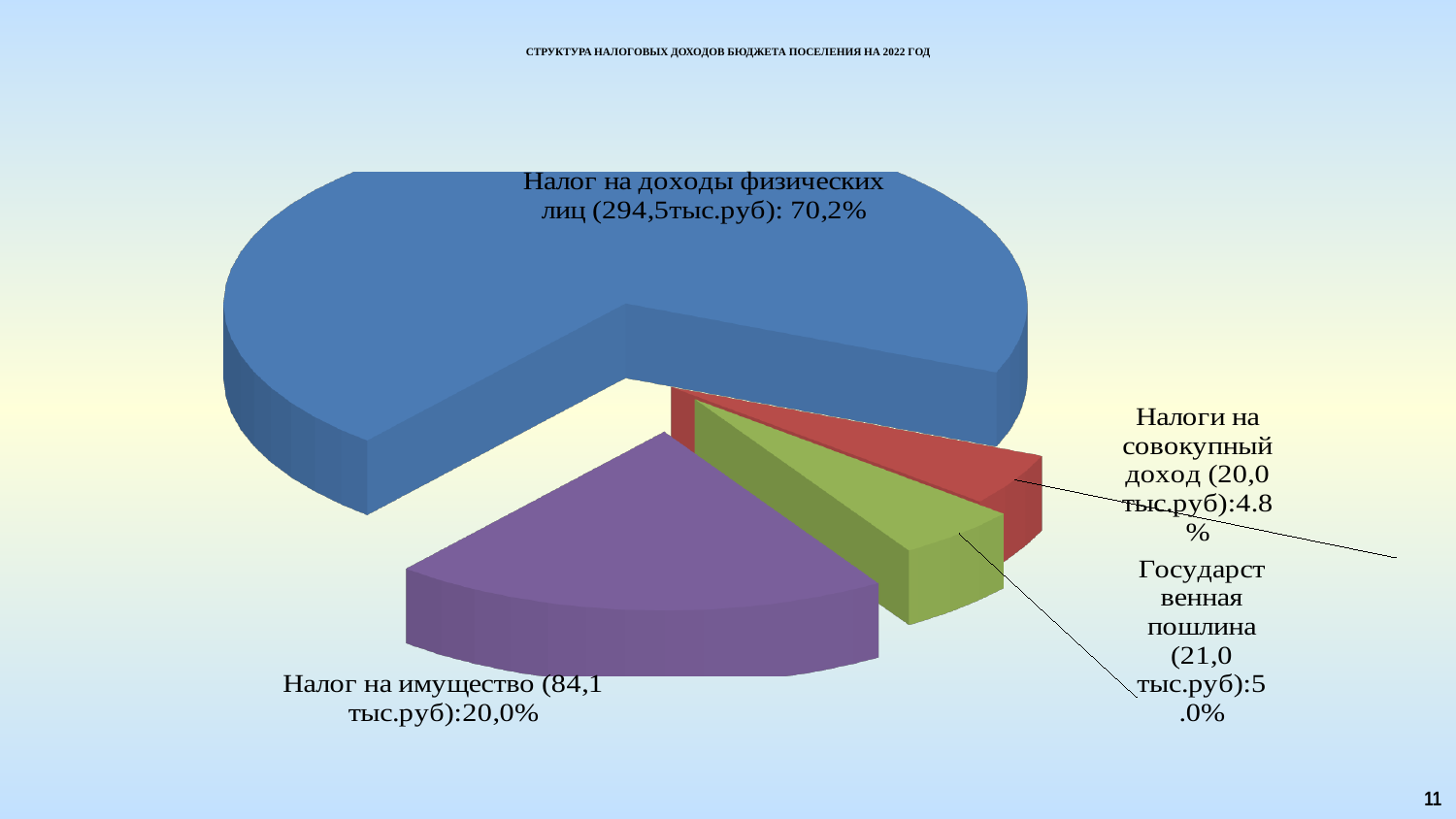
What is the title of the chart? СТРУКТУРА НАЛОГОВЫХ ДОХОДОВ БЮДЖЕТА ПОСЕЛЕНИЯ НА 2022 ГОД What share of the pie does Налоги на совокупный доход have? 4.8% What share of the pie does Налог на доходы физических лиц have? 70,2% What is the difference in тыс.руб between Налог на доходы физических лиц and Налог на имущество? 210,4 Which is larger: Налог на доходы физических лиц or Налог на имущество? Налог на доходы физических лиц Which category has the smallest slice of the pie? Налоги на совокупный доход What is the value in тыс.руб for Государственная пошлина? 21,0 Which category has the largest slice of the pie? Налог на доходы физических лиц What colour is the slice for Налог на имущество? Purple What is the value in тыс.руб for Налог на имущество? 84,1 What kind of chart is shown on the slide? Pie chart How many slices does the pie chart have? 4